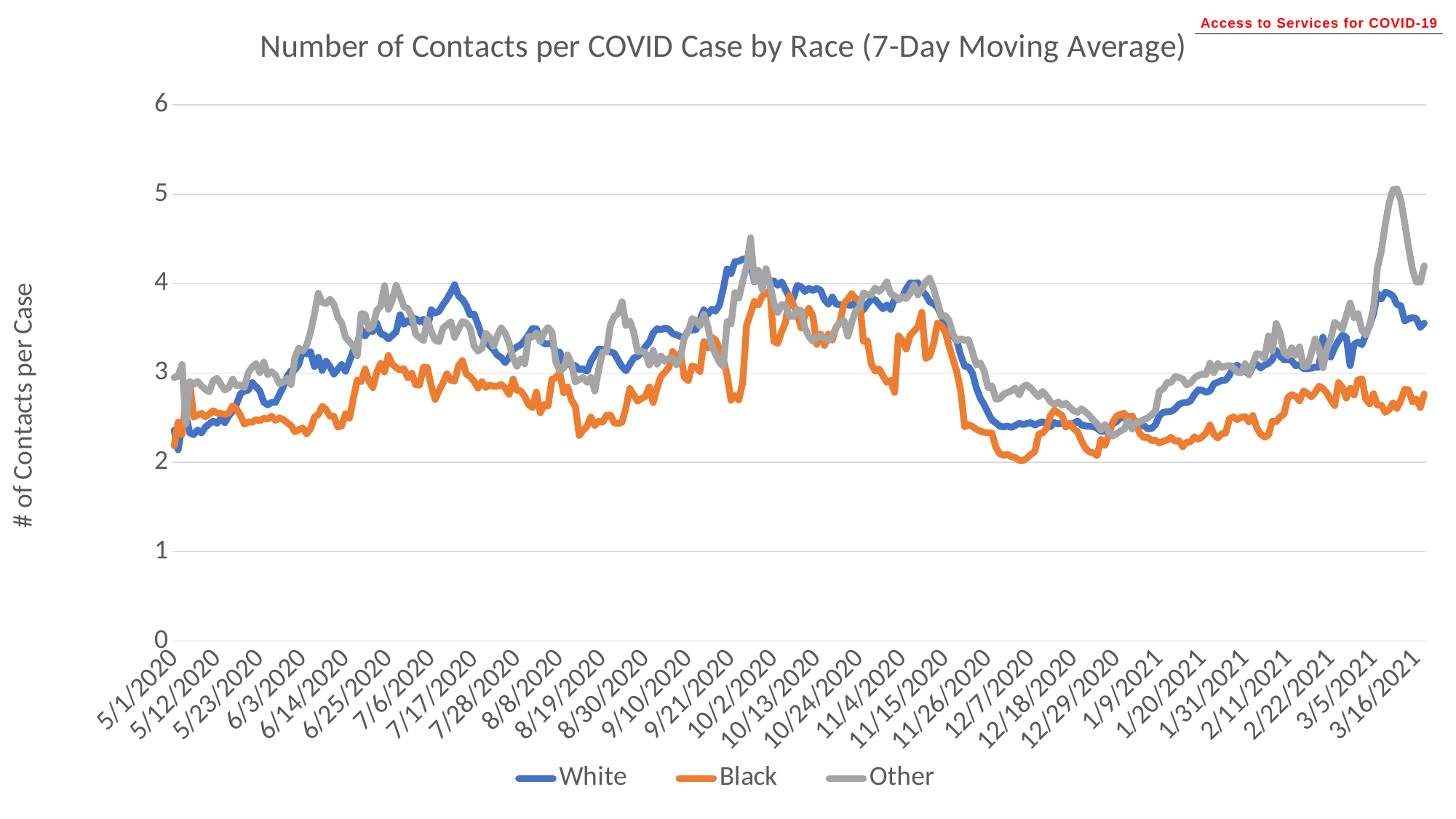
Is the peak value for Other around 3/5/2021 greater or less than 4? greater Is the value for Black around 12/7/2020 greater or less than 2.5? less What is the label on the vertical axis? # of Contacts per Case Which series reaches the highest value anywhere on the chart? Other What kind of chart is shown on the slide? Line chart How many date labels are shown on the horizontal axis? 30 How many series does the legend list? 3 Does the Black series rise or fall between 11/15/2020 and 12/7/2020? Fall What is the title of the chart? Number of Contacts per COVID Case by Race (7-Day Moving Average) Around 7/17/2020, which series has the higher value, White or Black? White Which series reaches the lowest value anywhere on the chart? Black